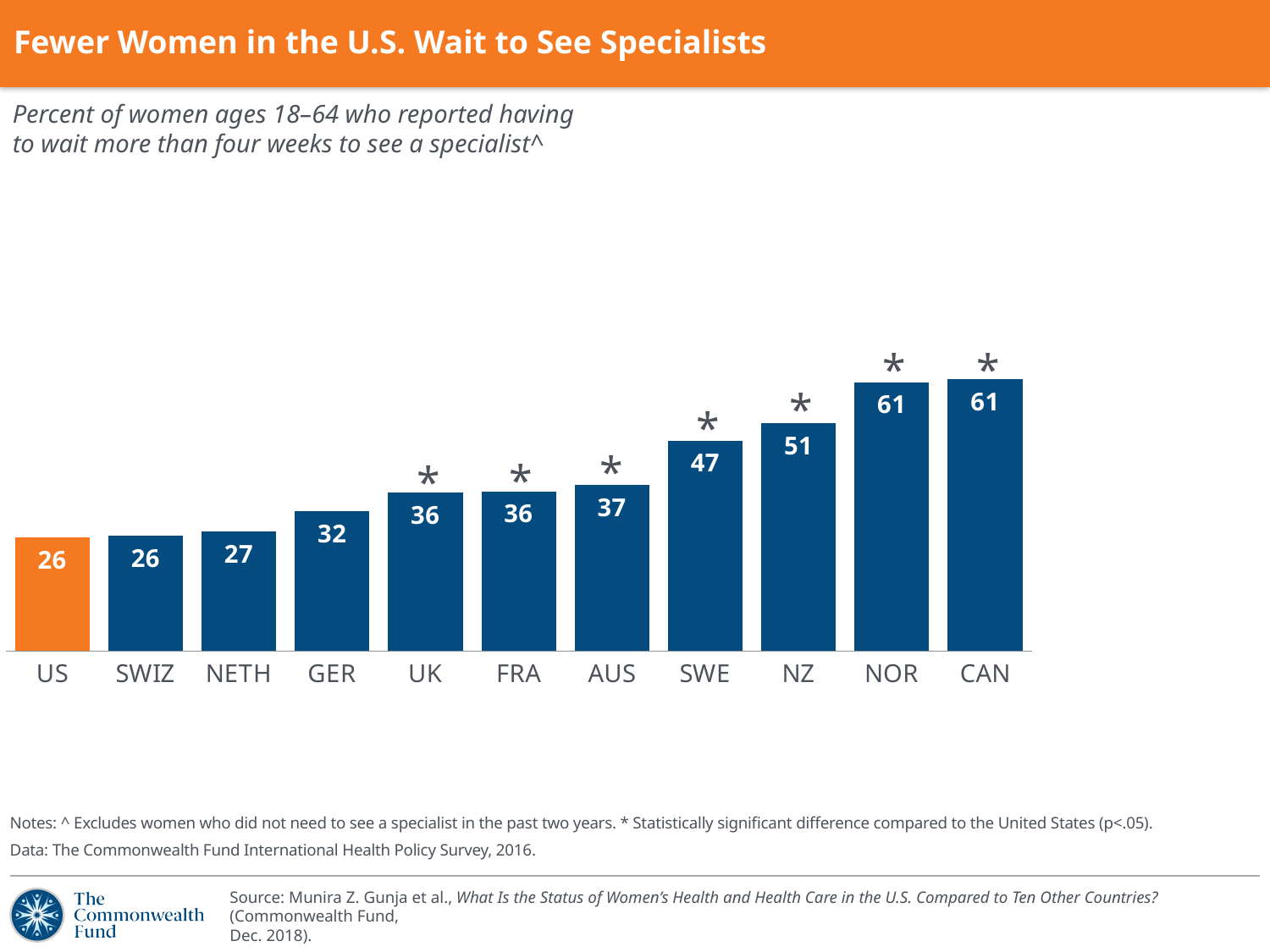
Which is larger, the value for SWE or the value for FRA? SWE What is the value for GER? 32 How many countries are shown on the chart? 11 Which countries have the highest value? NOR and CAN What is the value for SWE? 47 What is the value for NZ? 51 Which bar is coloured orange rather than blue? US What is the difference between the values for NZ and AUS? 14 Which countries have the lowest value? US and SWIZ What is the value for the US? 26 What is the difference between the values for CAN and US? 35 What kind of chart is shown on the slide? Bar chart